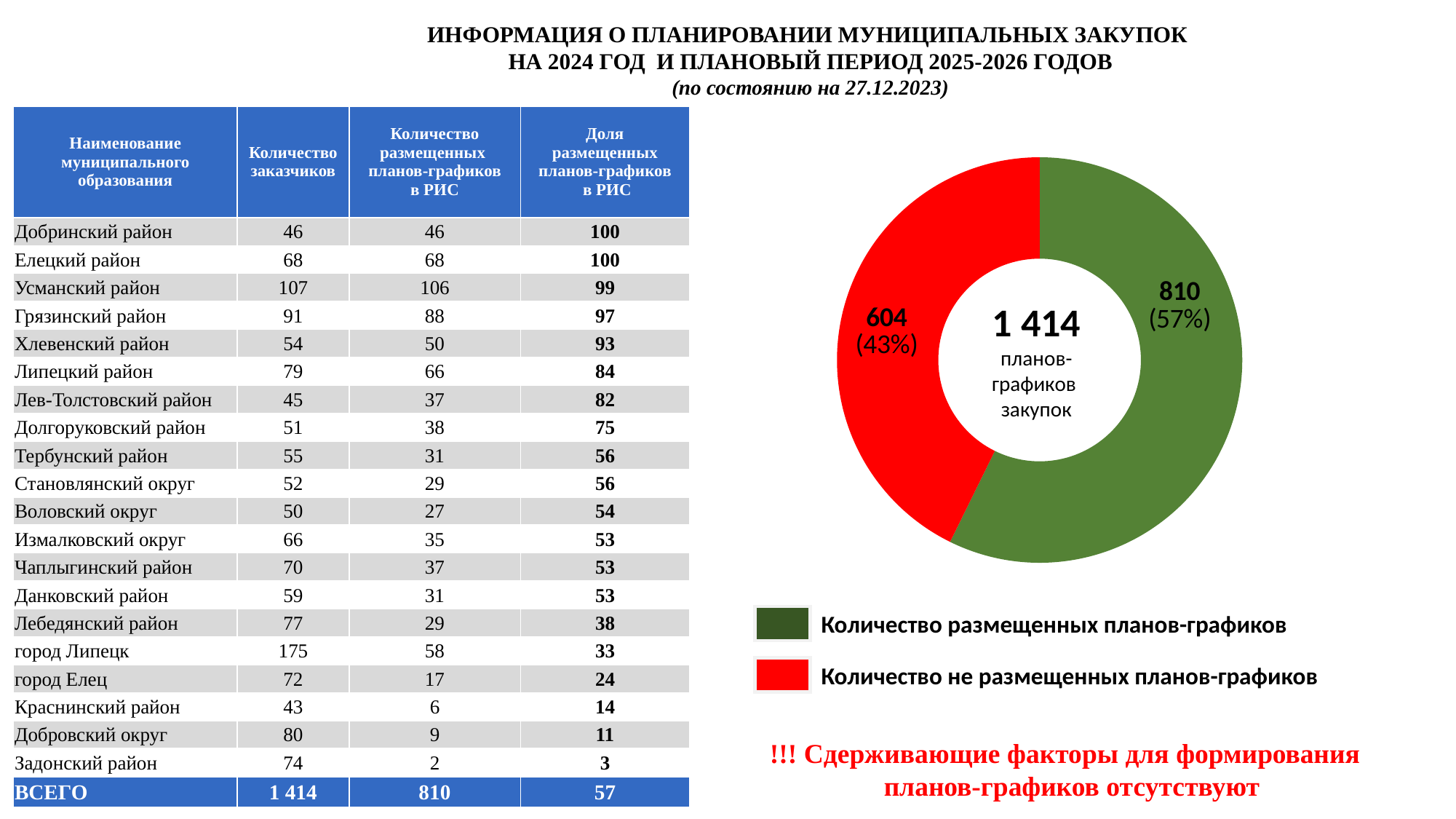
What is the difference between the two values shown in the donut chart (810 and 604)? 206 How many slices does the donut chart have? 2 What total is shown in the centre of the donut chart? 1 414 What colour is the slice for 'Количество не размещенных планов-графиков' in the donut chart? Red What share of the donut chart does 'Количество размещенных планов-графиков' represent? 57% What share of the donut chart does 'Количество не размещенных планов-графиков' represent? 43% What kind of chart is shown on the right side of the slide? Pie chart (donut) Which slice of the donut chart is larger: 'Количество размещенных планов-графиков' or 'Количество не размещенных планов-графиков'? Количество размещенных планов-графиков What is the value for 'Количество размещенных планов-графиков' in the donut chart? 810 What is the value for 'Количество не размещенных планов-графиков' in the donut chart? 604 How many series does the legend of the donut chart list? 2 What colour is the slice for 'Количество размещенных планов-графиков' in the donut chart? Green